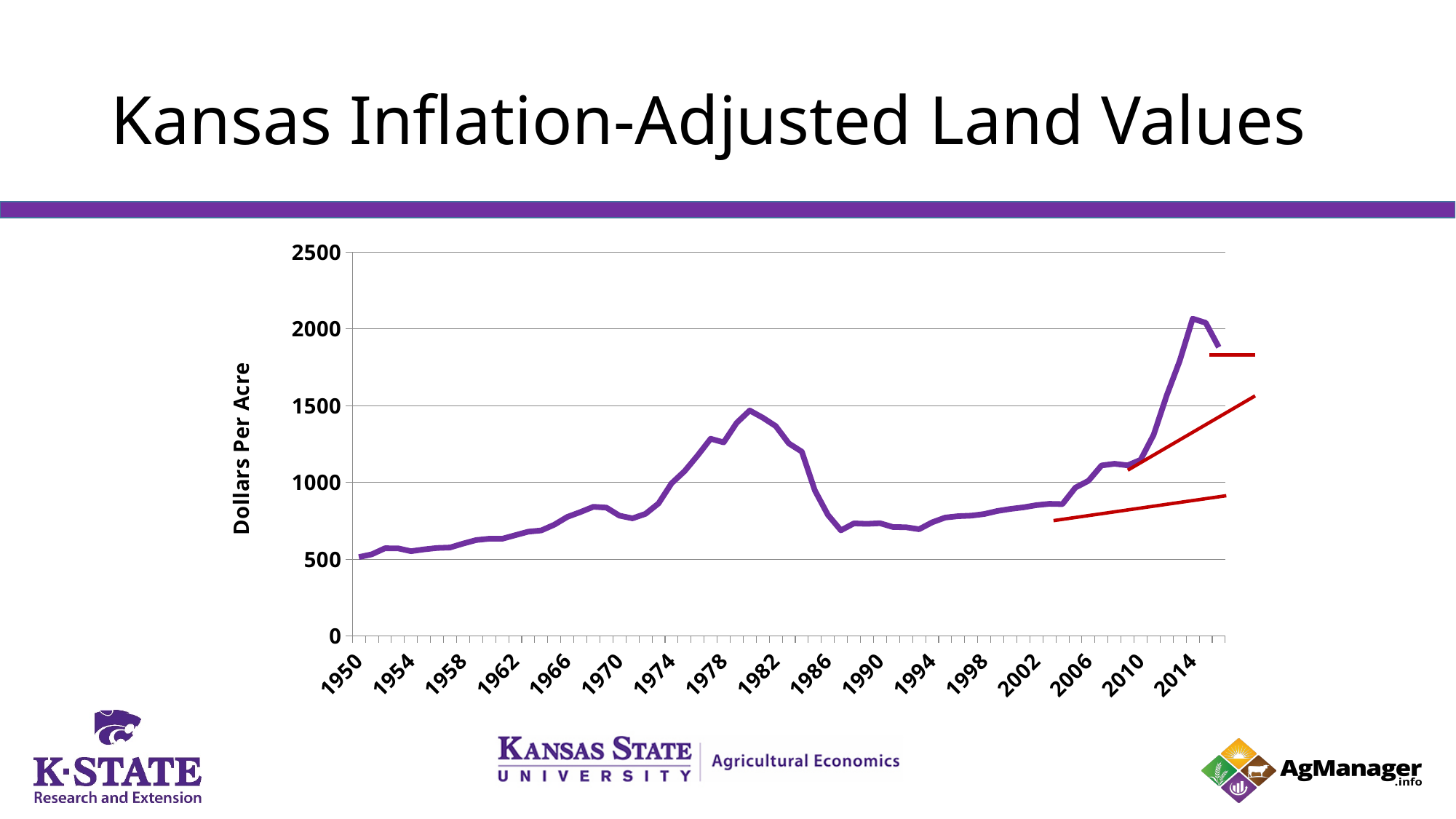
Is the land value for 2014 greater or less than 1500? greater What is the label on the vertical axis of the chart? Dollars Per Acre Is the land value for 1950 greater or less than 1000? less Is the land value for 1990 greater or less than 1000? less Which year has the larger land value, 1978 or 1990? 1978 Do land values rise or fall between 1982 and 1986? fall What kind of chart is shown on the slide? Line chart What is the title of the chart on the slide? Kansas Inflation-Adjusted Land Values Do land values rise or fall between 1950 and 1970? rise How many year labels are shown on the horizontal axis? 17